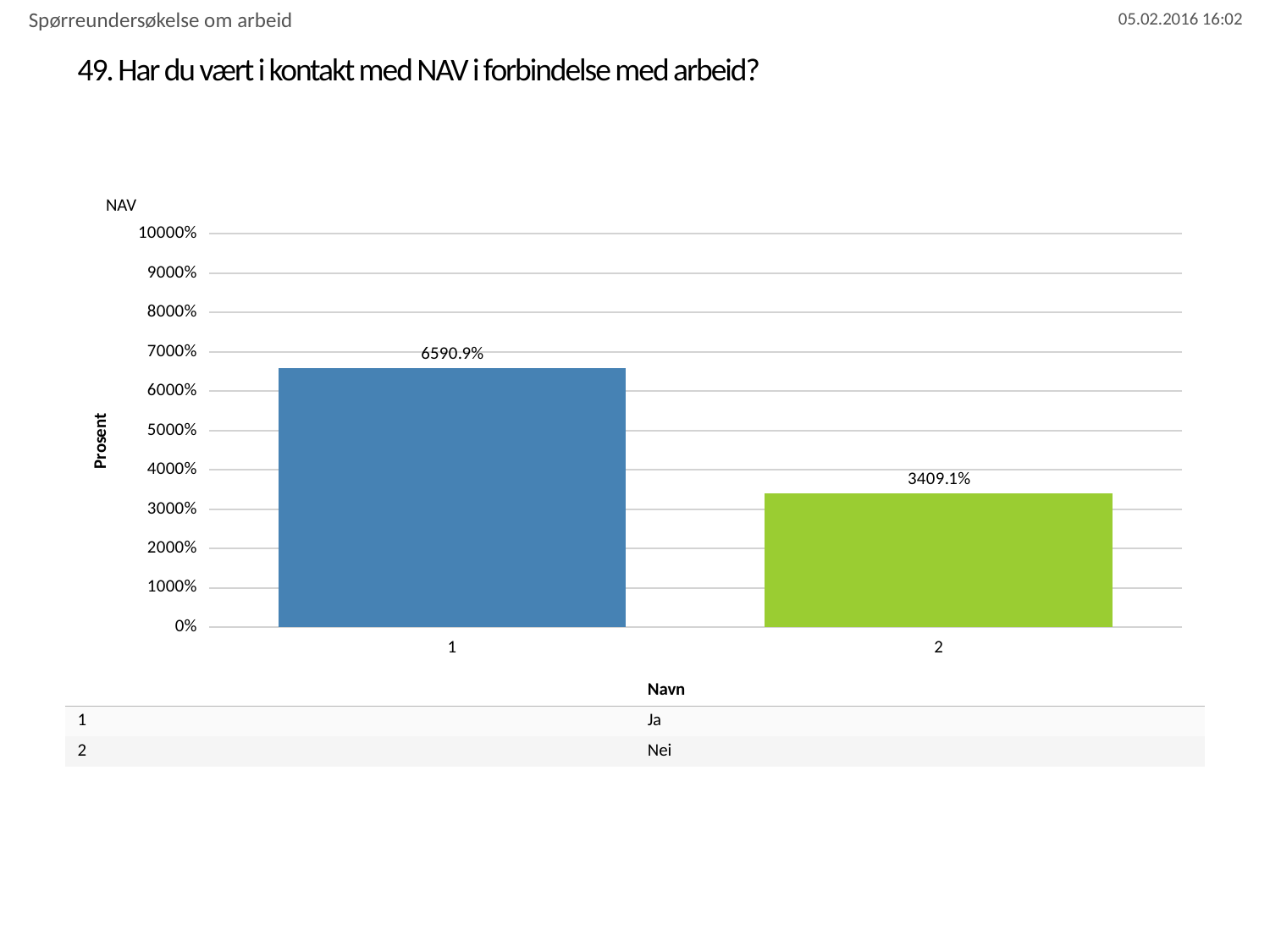
Which is larger in the NAV chart, the value for category 1 or category 2? 1 Which category has the highest value in the NAV chart? 1 Is the value for category 2 in the NAV chart greater or less than 4000%? less What is the label of the vertical axis in the NAV chart? Prosent What is the value for category 1 in the NAV chart? 6590.9% How many bars are plotted in the NAV chart? 2 What kind of chart is shown on the slide? bar chart Is the value for category 1 in the NAV chart greater or less than 6000%? greater Which category has the lowest value in the NAV chart? 2 What is the value for category 2 in the NAV chart? 3409.1% What is the difference between the values for category 1 and category 2 in the NAV chart? 3181.8% According to the table below the chart, what name does category 2 correspond to? Nei